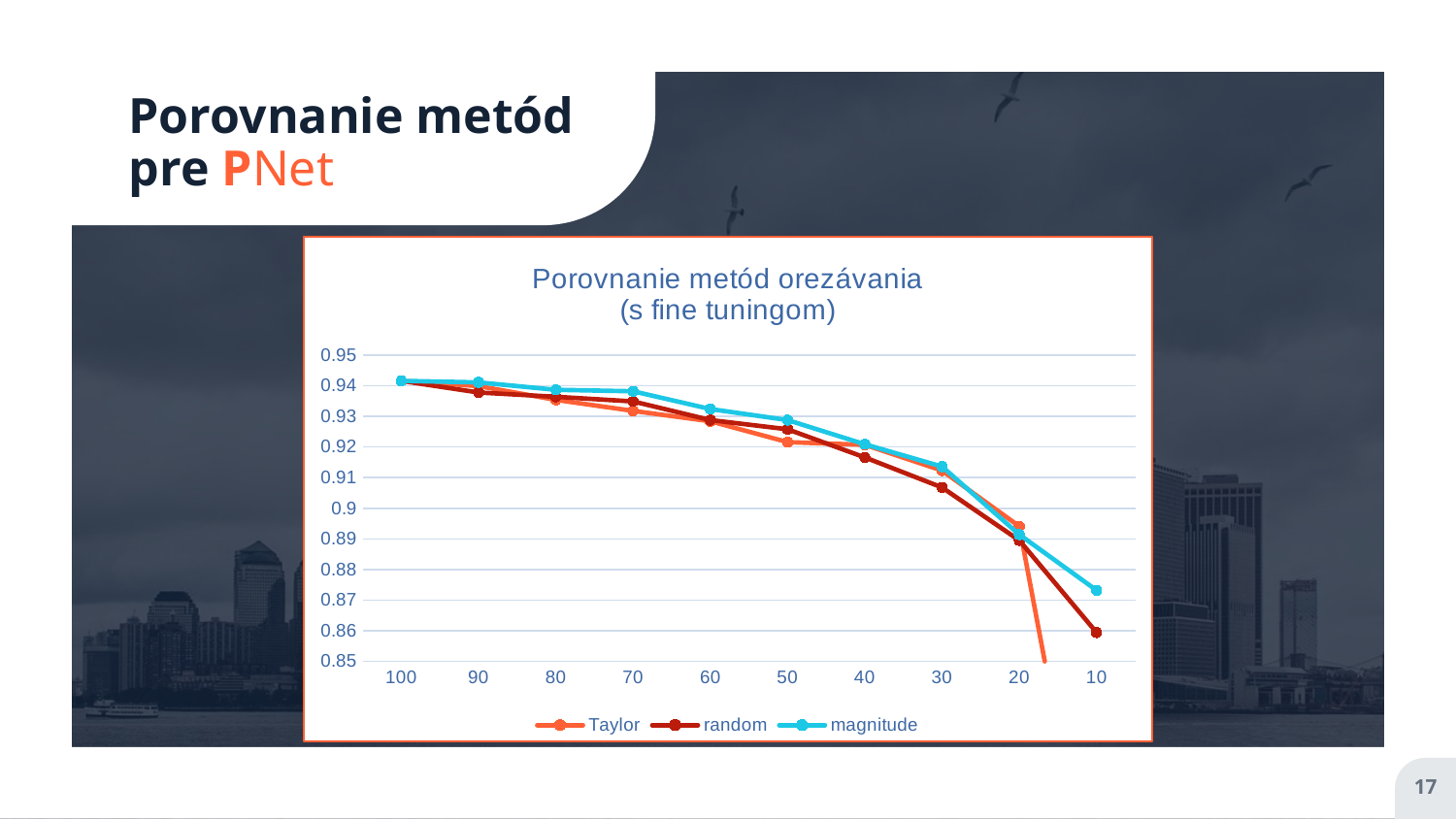
Is the value of the random series at x = 40 greater or less than 0.92? less Which series are listed in the chart legend? Taylor, random, magnitude Is the value of the magnitude series at x = 70 greater or less than 0.93? greater At x = 10, which series has the higher value, magnitude or random? magnitude What kind of chart is shown on the slide? line chart What is the title of the chart? Porovnanie metód orezávania (s fine tuningom) Do the values of the magnitude series rise or fall as the x axis goes from 100 to 10? fall How many points are marked along the x axis of the chart? 10 At x = 50, which series has the higher value, Taylor or magnitude? magnitude Is the value of the magnitude series at x = 10 greater or less than 0.88? less How many series does the chart legend list? 3